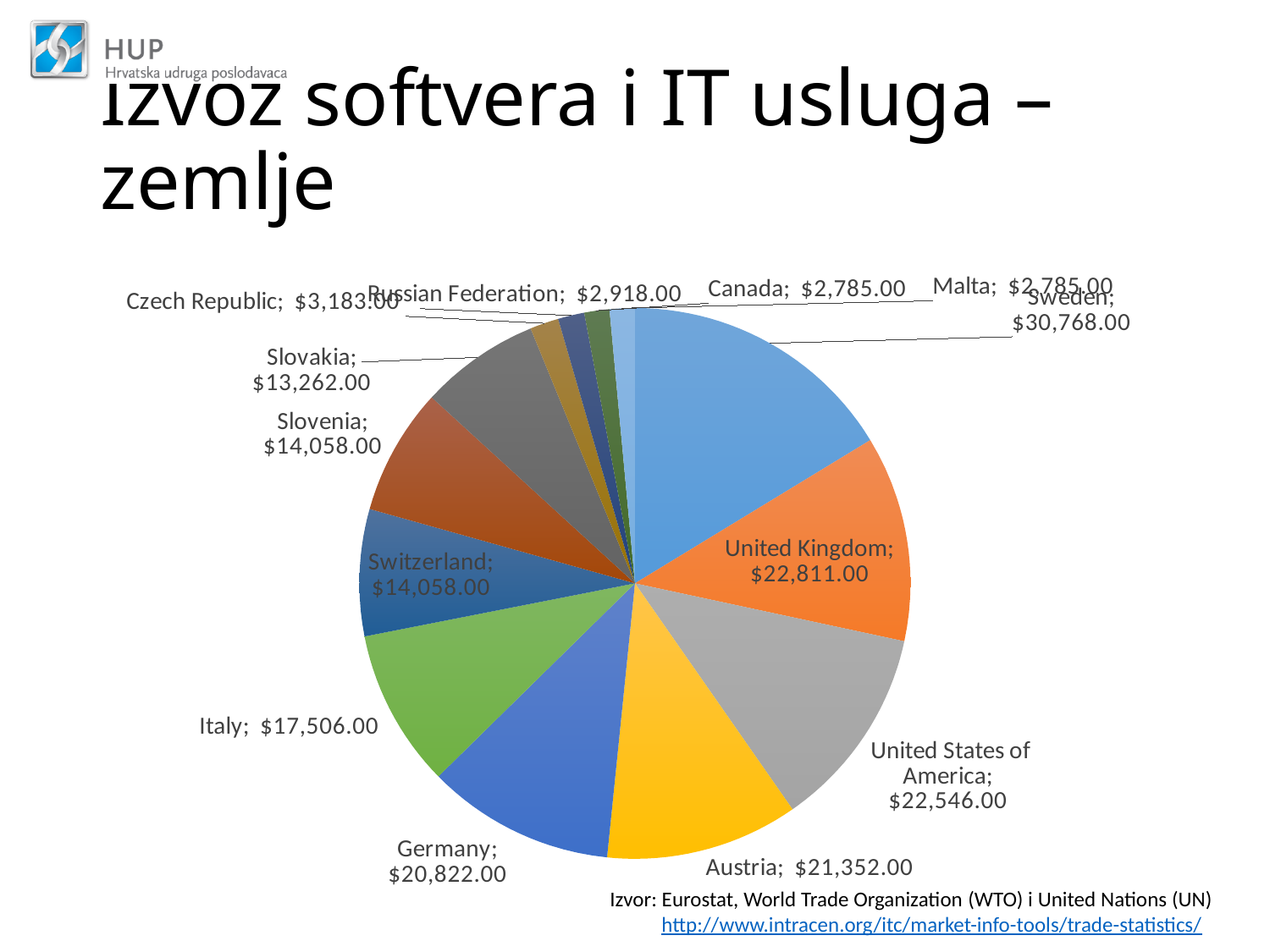
What is the difference between the values for Sweden and United Kingdom? $7,957.00 What is the difference between the values for Switzerland and Slovakia? $796.00 What is the value for United States of America? $22,546.00 Which is larger, the value for Czech Republic or the value for Canada? Czech Republic What is the value for United Kingdom? $22,811.00 What is the value for Slovakia? $13,262.00 What type of chart is shown on the slide? pie chart What is the value for Russian Federation? $2,918.00 What is the value for Sweden? $30,768.00 What is the value for Austria? $21,352.00 Which is larger, the value for Germany or the value for Italy? Germany Which country has the largest slice of the pie? Sweden